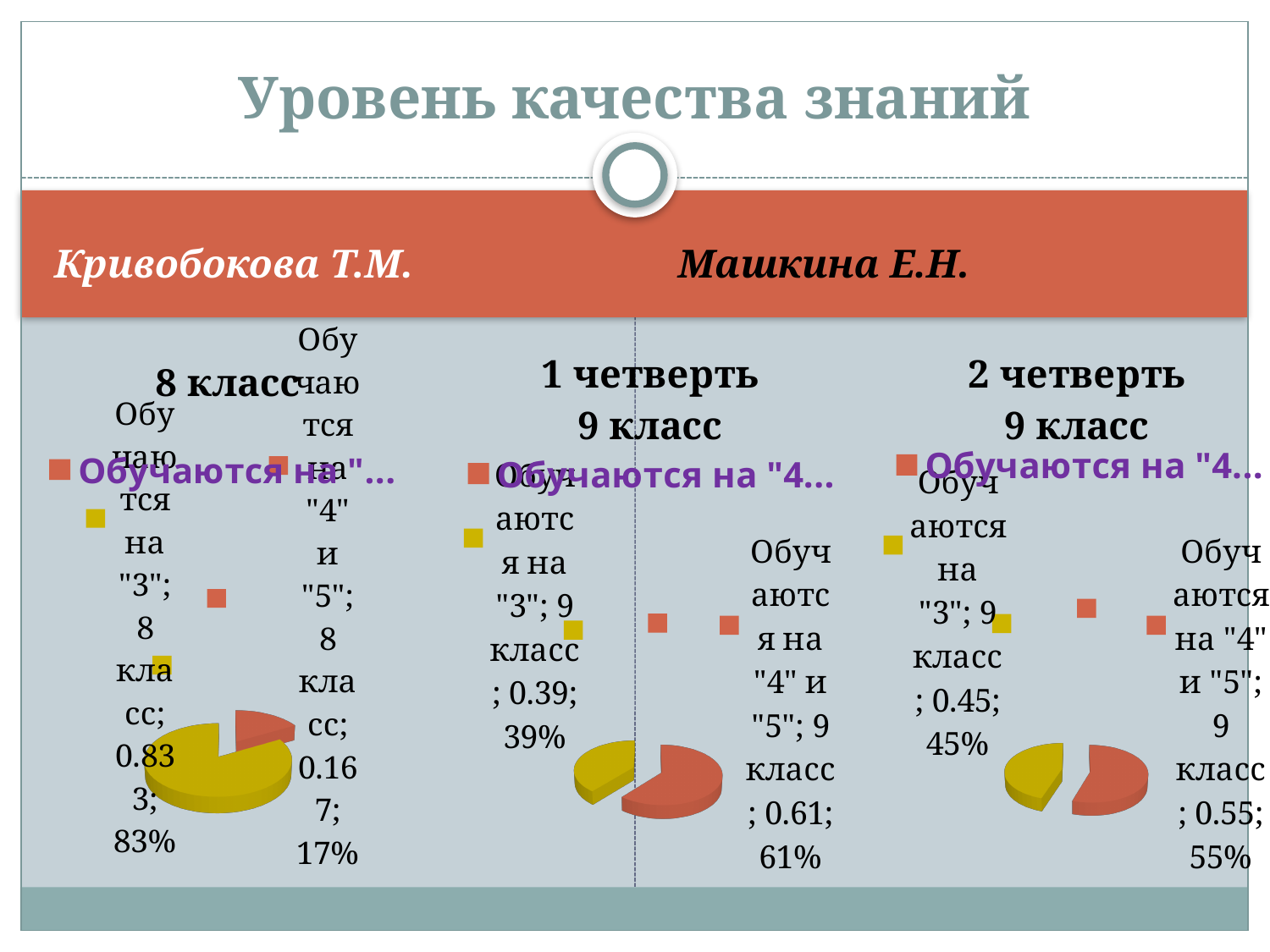
What type of chart is the "8 класс" chart? Pie chart In the "2 четверть 9 класс" chart, what percentage is shown for the slice "Обучаются на "3""? 45% In the "8 класс" chart, which slice is the largest? Обучаются на "3" In the "1 четверть 9 класс" chart, what percentage is shown for the slice "Обучаются на "4" и "5""? 61% In the "2 четверть 9 класс" chart, what percentage is shown for the slice "Обучаются на "4" и "5""? 55% In the "8 класс" chart, what percentage is shown for the slice "Обучаются на "4" и "5""? 17% In the "1 четверть 9 класс" chart, what percentage is shown for the slice "Обучаются на "3""? 39% In the "8 класс" chart, what percentage is shown for the slice "Обучаются на "3""? 83% In the "1 четверть 9 класс" chart, what is the difference in percentage points between the "Обучаются на "4" и "5"" slice and the "Обучаются на "3"" slice? 22 In the "1 четверть 9 класс" chart, which slice is the smallest? Обучаются на "3" In the "2 четверть 9 класс" chart, which slice is larger: "Обучаются на "3"" or "Обучаются на "4" и "5""? Обучаются на "4" и "5" How many slices does the "2 четверть 9 класс" chart have? 2